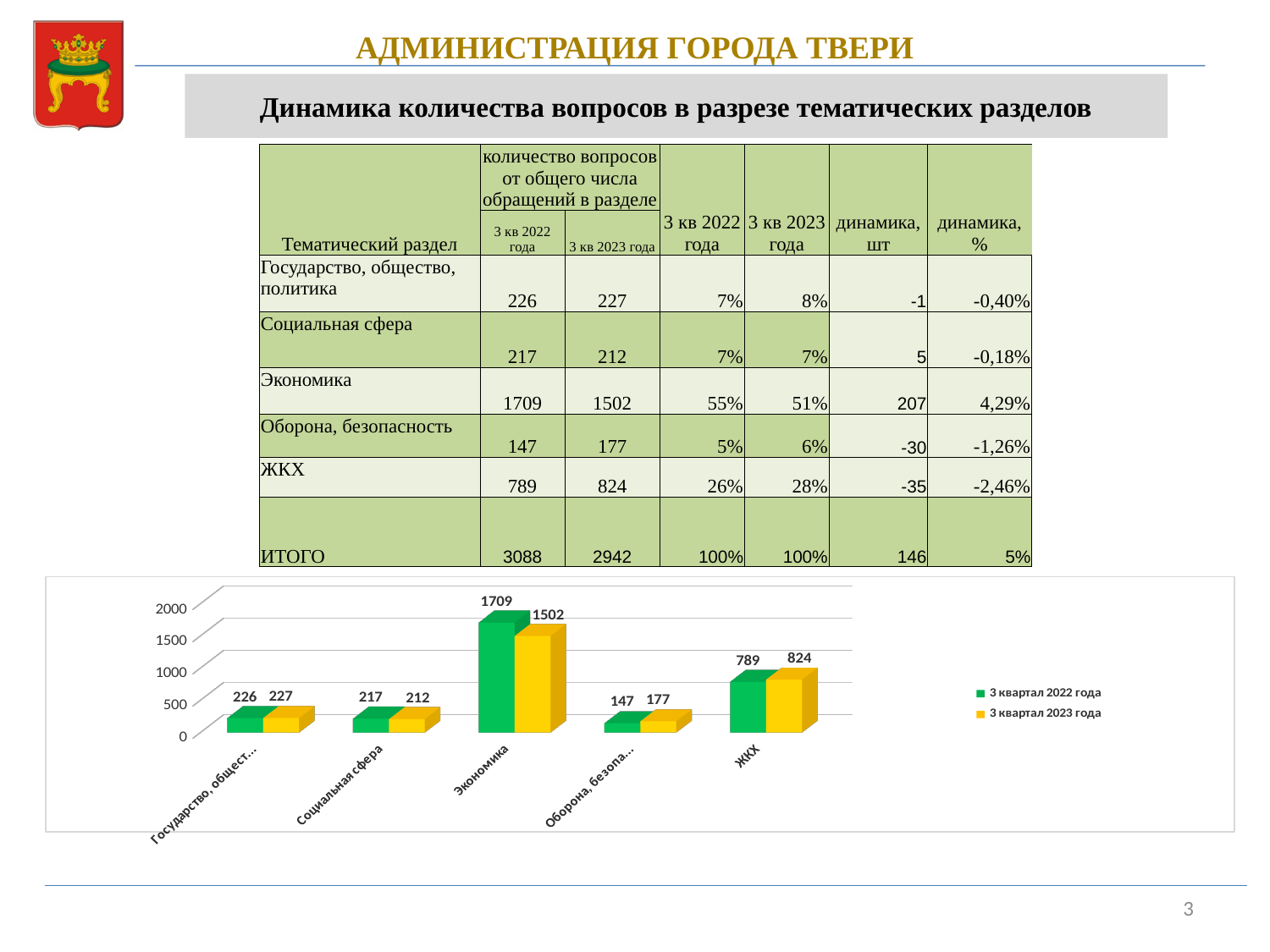
What is the value for Социальная сфера in the series 3 квартал 2023 года? 212 Which category has the lowest value in the series 3 квартал 2023 года? Оборона, безопасность How many series does the chart legend list? 2 Which category has the highest value in the series 3 квартал 2022 года? Экономика What is the value for Экономика in the series 3 квартал 2022 года? 1709 What is the difference between the 3 квартал 2022 года and 3 квартал 2023 года values for Экономика? 207 What type of chart is shown on the slide? bar chart Which colour represents the series 3 квартал 2023 года in the chart? yellow For ЖКХ, which series has the larger value: 3 квартал 2022 года or 3 квартал 2023 года? 3 квартал 2023 года Is the value for ЖКХ in the series 3 квартал 2022 года greater or less than 500? greater What is the value for ЖКХ in the series 3 квартал 2023 года? 824 How many categories are plotted on the chart's x axis? 5